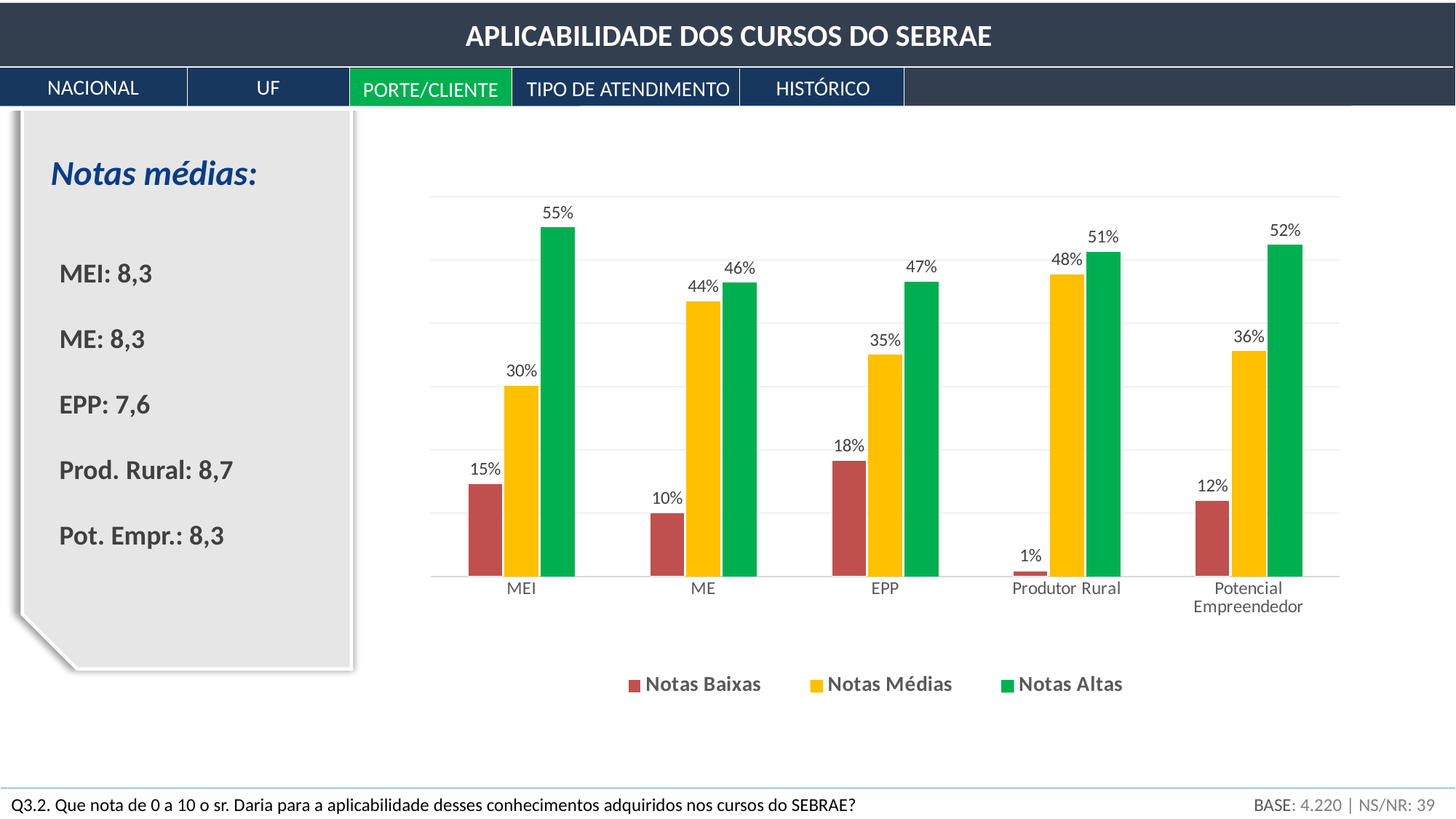
What is the value of Notas Baixas for Produtor Rural? 1% What kind of chart is shown on the slide? Bar chart How many categories are shown on the x axis? 5 Which category has the highest Notas Altas value? MEI What is the value of Notas Médias for Potencial Empreendedor? 36% Which category has the lowest Notas Baixas value? Produtor Rural What is the difference between Notas Altas and Notas Médias for EPP? 12% What is the value of Notas Baixas for EPP? 18% What is the value of Notas Altas for MEI? 55% Which series is shown in green in the legend? Notas Altas Which is larger: Notas Médias for ME or Notas Médias for Produtor Rural? Produtor Rural How many series does the legend list? 3